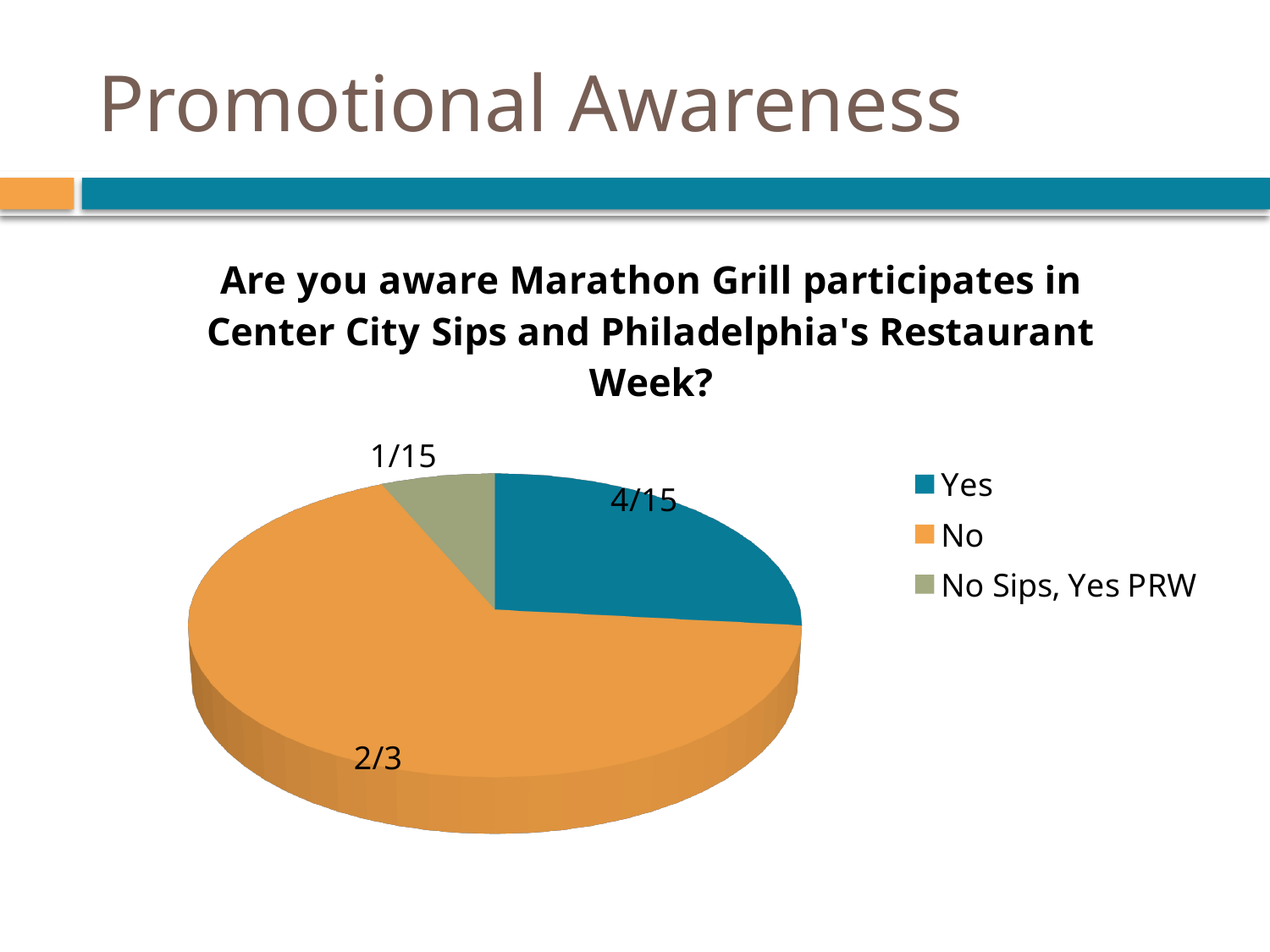
What colour is the "Yes" slice in the pie chart? blue What is the value shown for the "No Sips, Yes PRW" slice? 1/15 What is the title of the pie chart? Are you aware Marathon Grill participates in Center City Sips and Philadelphia's Restaurant Week? Which category has the largest slice of the pie? No What kind of chart is shown on the slide? pie chart What is the value shown for the "No" slice? 2/3 Which slice is larger, "Yes" or "No Sips, Yes PRW"? Yes Which category has the smallest slice of the pie? No Sips, Yes PRW How many slices does the pie chart have? 3 Which slice is larger, "Yes" or "No"? No How many entries does the legend list? 3 What is the value shown for the "Yes" slice? 4/15